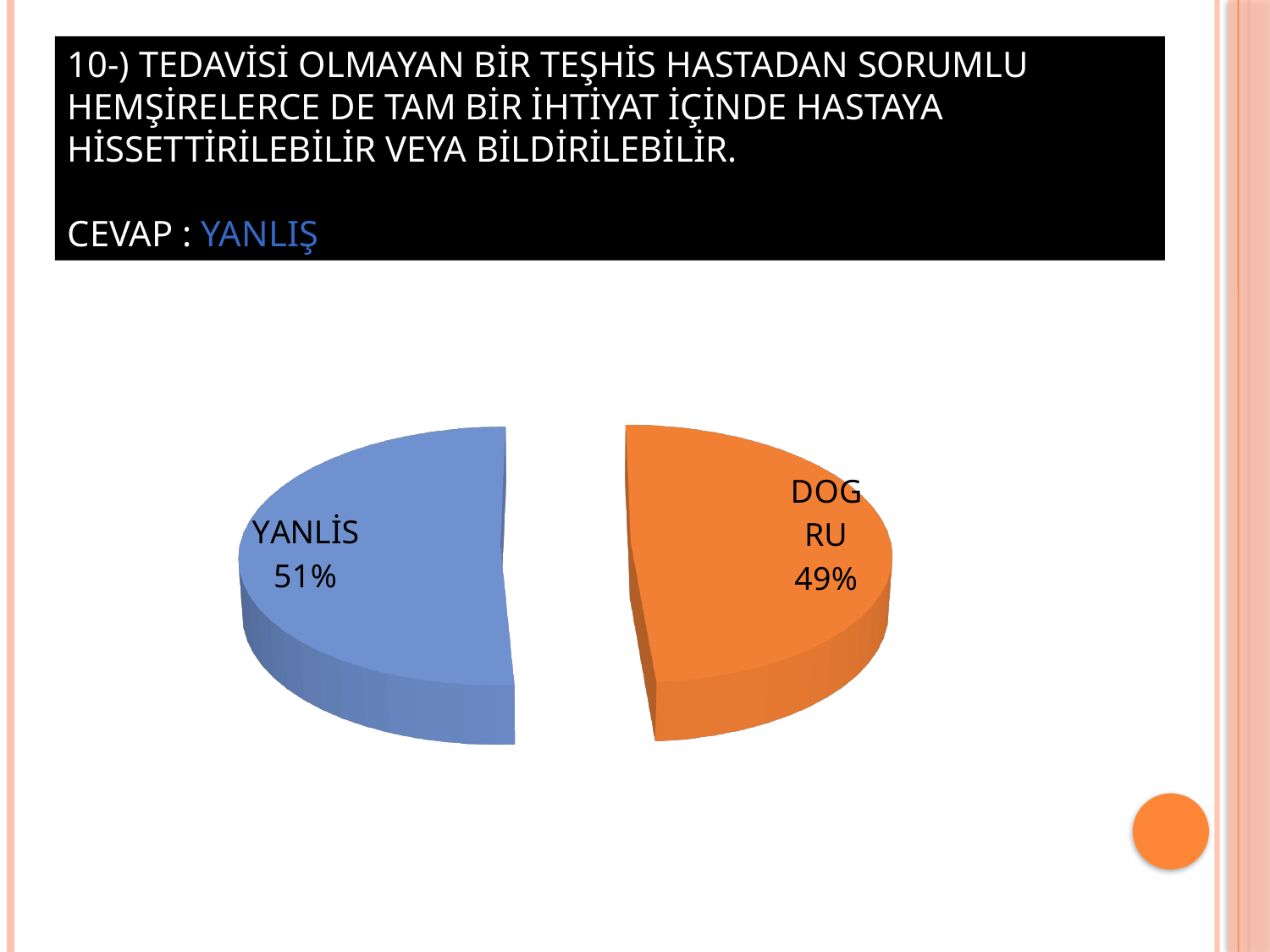
What percentage of the pie chart is labelled DOGRU? 49% Which slice of the pie chart is the largest? YANLİS What colour is the DOGRU slice in the pie chart? Orange Which slice is larger, YANLİS or DOGRU? YANLİS How many slices does the pie chart have? 2 What percentage of the pie chart is labelled YANLİS? 51% What share of the pie does the DOGRU slice represent? 49% Which slice of the pie chart is the smallest? DOGRU What colour is the YANLİS slice in the pie chart? Blue Is the YANLİS slice greater or less than 50% of the pie? greater What is the difference between the YANLİS and DOGRU percentages in the pie chart? 2% What kind of chart is shown on the slide? Pie chart